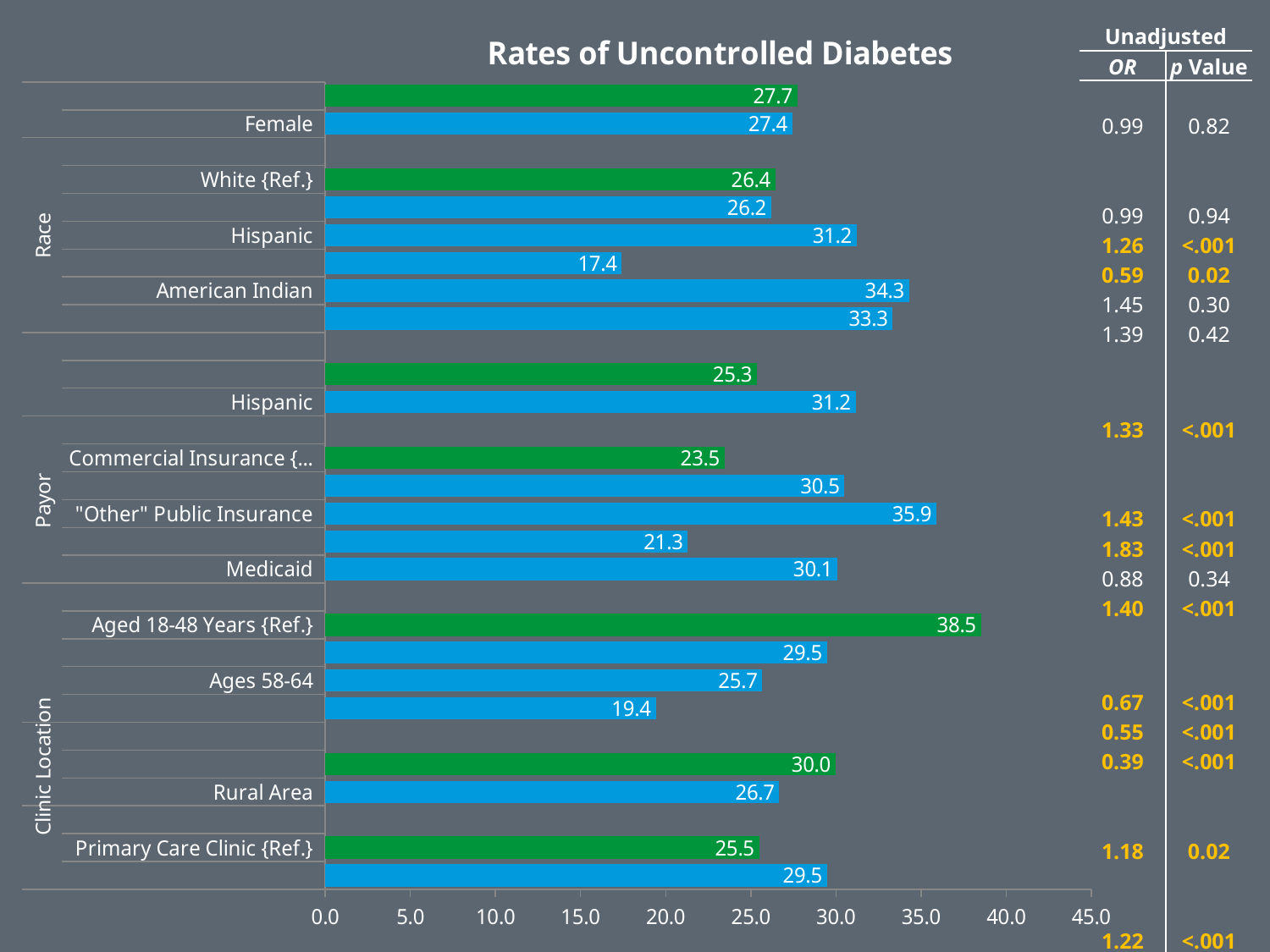
What is the value for Rural Area? 26.7 What is the title of the chart? Rates of Uncontrolled Diabetes What type of chart is shown on the slide? bar chart What is the value for "Other" Public Insurance? 35.9 What is the difference between the values for Hispanic (in the Race group) and White {Ref.}? 4.8 What is the difference between the values for "Other" Public Insurance and Medicaid? 5.8 What is the value for Aged 18-48 Years {Ref.}? 38.5 Is the value for Primary Care Clinic {Ref.} greater or less than 30.0? less What is the value for American Indian? 34.3 Which is larger, the value for American Indian or the value for Medicaid? American Indian Which labeled category has the highest value? Aged 18-48 Years {Ref.} What is the value for Female? 27.4